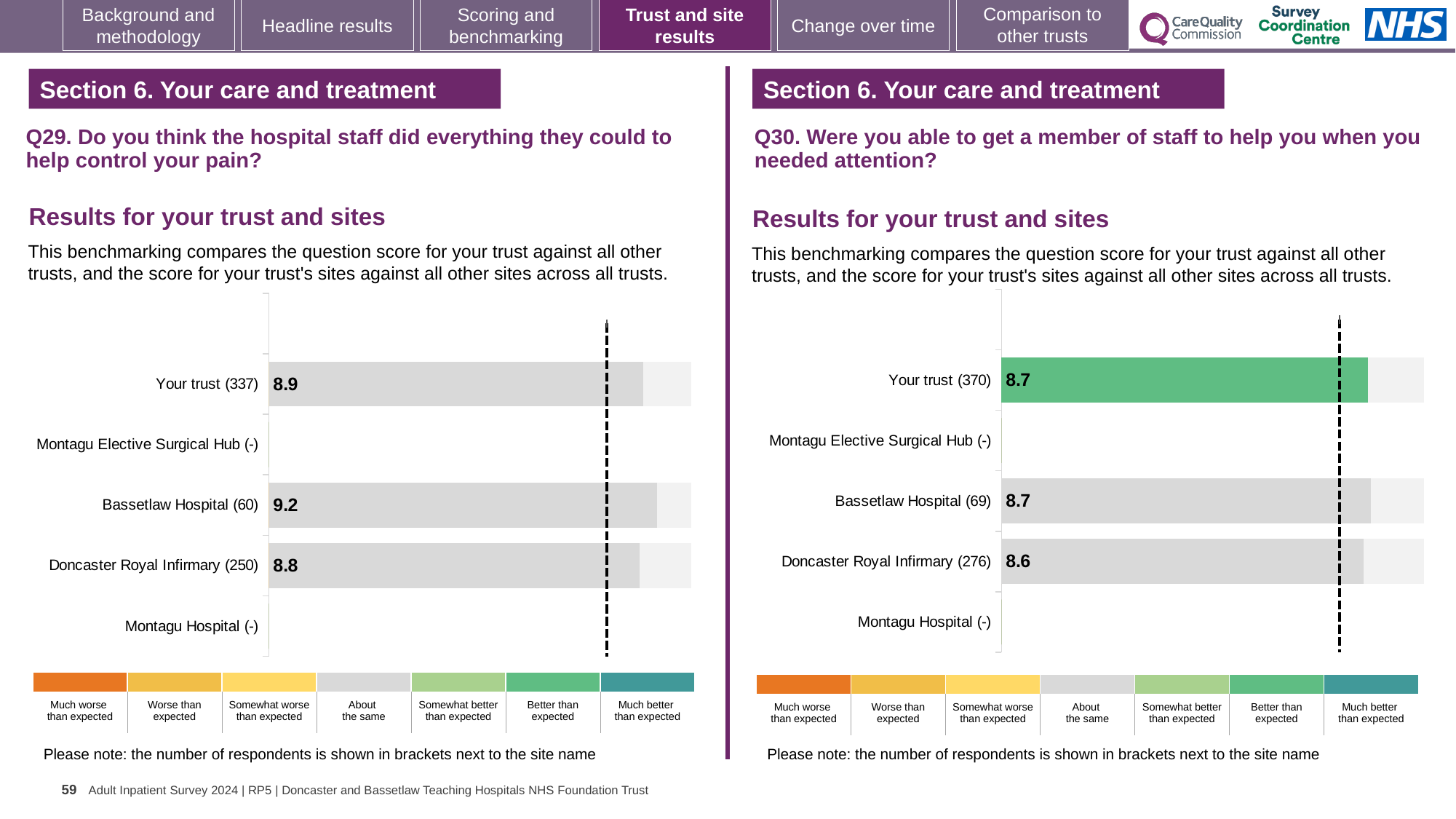
In the Q30 chart on the right, which site or trust row has the lowest score? Doncaster Royal Infirmary (276) In the Q29 chart on the left, what is the score for Your trust (337)? 8.9 What kind of chart is used for the Q30 results on the right? Bar chart In the Q29 chart on the left, what is the score for Bassetlaw Hospital (60)? 9.2 How many rows (trust and sites) are listed on the y axis of the Q29 chart on the left? 5 In the Q30 chart on the right, which benchmark category does the green colour of the Your trust (370) bar correspond to in the legend? Better than expected In the Q29 chart on the left, which site or trust row has the highest score? Bassetlaw Hospital (60) In the Q29 chart on the left, what is the difference between the scores for Bassetlaw Hospital (60) and Doncaster Royal Infirmary (250)? 0.4 In the Q29 chart on the left, which has the higher score: Your trust (337) or Doncaster Royal Infirmary (250)? Your trust (337) In the Q30 chart on the right, what is the score for Doncaster Royal Infirmary (276)? 8.6 In the Q30 chart on the right, what is the score for Your trust (370)? 8.7 In the Q30 chart on the right, what is the difference between the scores for Bassetlaw Hospital (69) and Doncaster Royal Infirmary (276)? 0.1